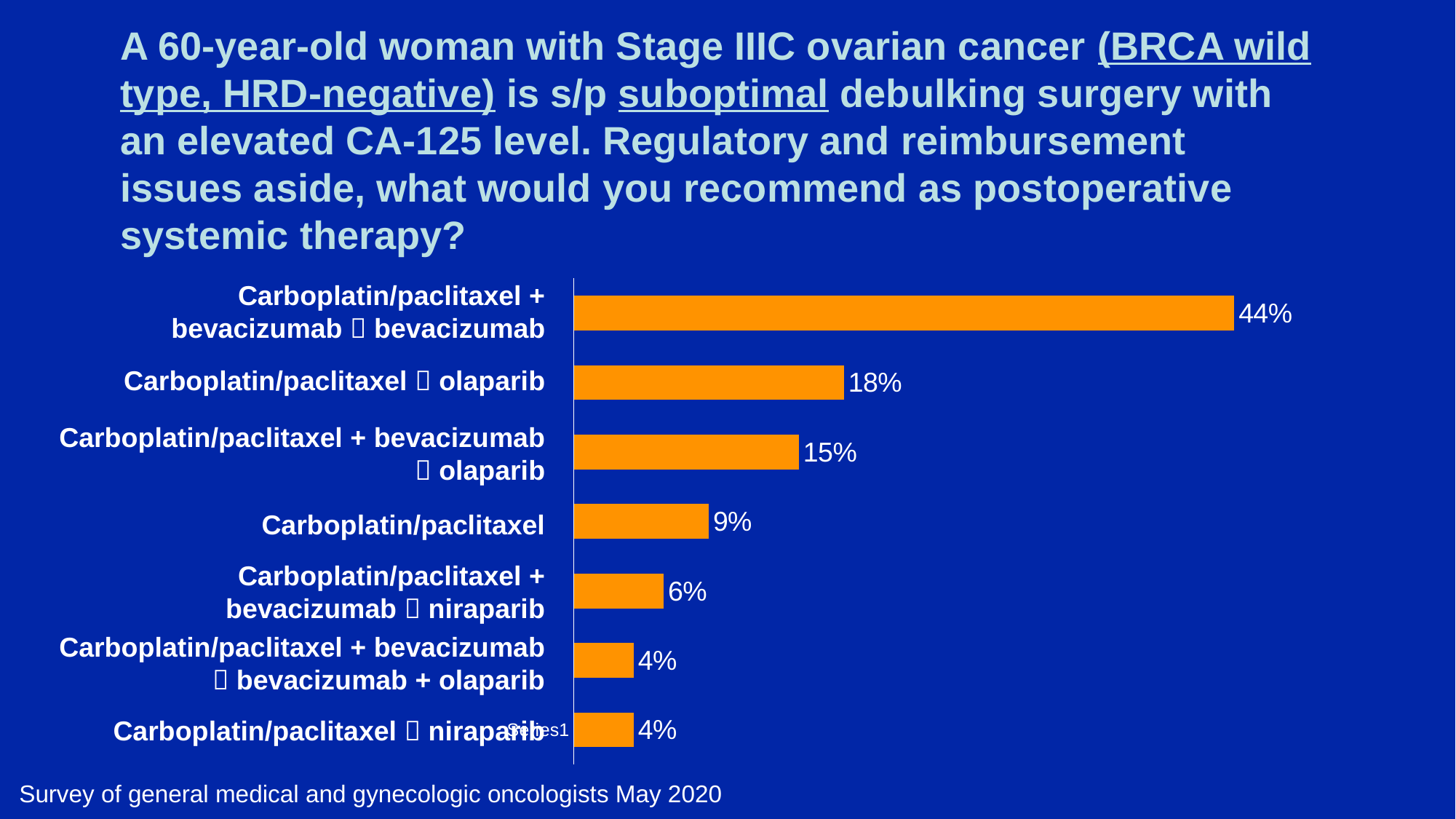
What percentage of respondents chose carboplatin/paclitaxel + bevacizumab followed by bevacizumab maintenance? 44% What percentage of respondents chose carboplatin/paclitaxel alone? 9% What percentage of respondents chose carboplatin/paclitaxel followed by olaparib? 18% Which treatment option received the highest percentage of responses? Carboplatin/paclitaxel + bevacizumab followed by bevacizumab What is the combined percentage for the two options that each received 4%? 8% Which received a larger share of responses: carboplatin/paclitaxel followed by olaparib, or carboplatin/paclitaxel alone? Carboplatin/paclitaxel followed by olaparib According to the footnote, who was surveyed and when? General medical and gynecologic oncologists, May 2020 What is the difference in percentage points between the top option (44%) and carboplatin/paclitaxel followed by olaparib (18%)? 26 percentage points What percentage of respondents chose carboplatin/paclitaxel + bevacizumab followed by niraparib? 6% What type of chart is shown on the slide? Bar chart How many treatment options are shown in the chart? 7 What percentage of respondents chose carboplatin/paclitaxel + bevacizumab followed by olaparib? 15%